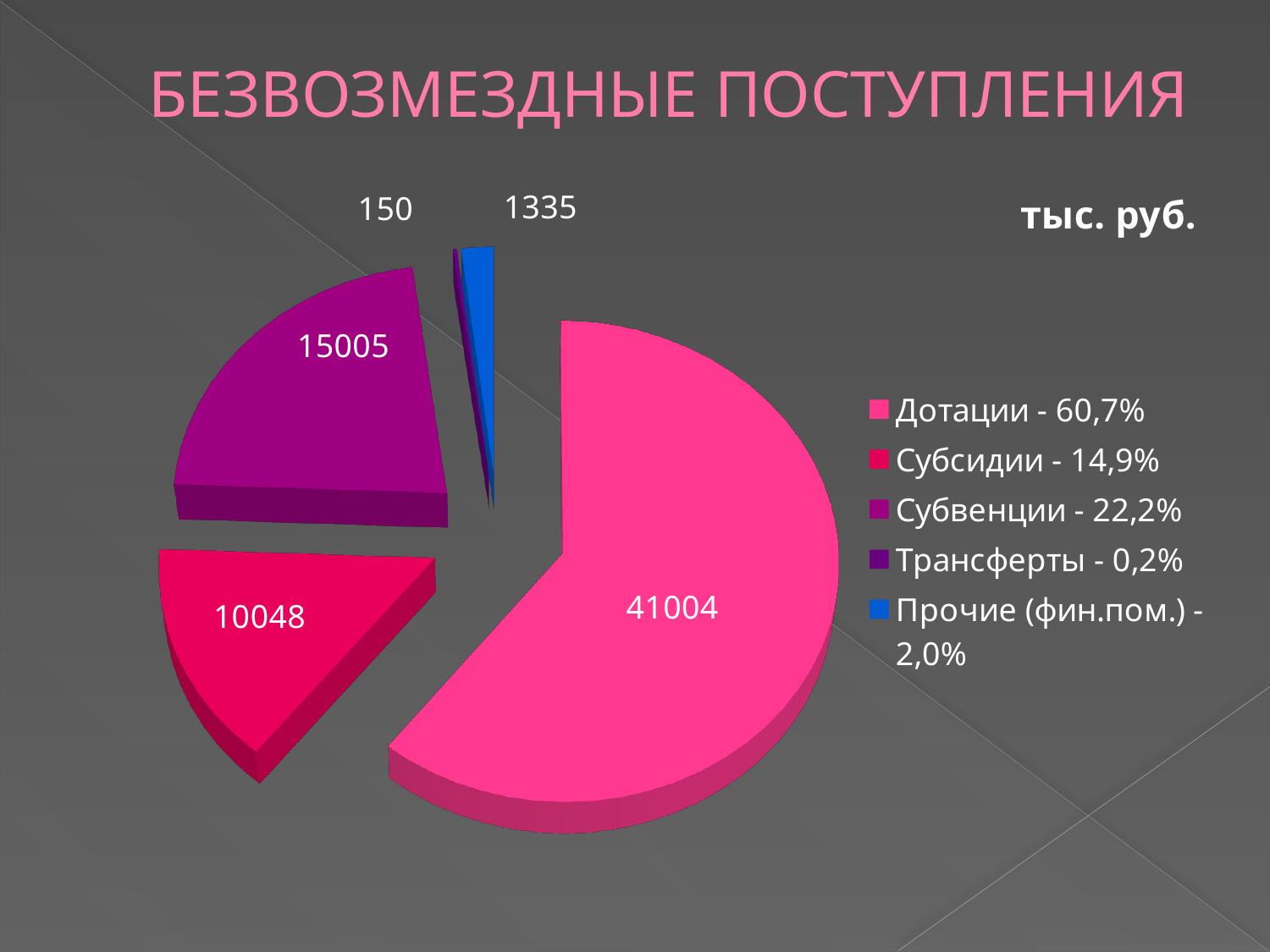
Which category has the smallest slice? Трансферты What kind of chart is shown on the slide? pie chart What is the value for Субвенции? 15005 Which is larger, the value for Субсидии or the value for Субвенции? Субвенции What is the value for Прочие (фин.пом.)? 1335 What is the value for Субсидии? 10048 What is the value for Дотации? 41004 What unit is indicated for the values on the chart? тыс. руб. What is the difference between the values for Субвенции and Субсидии? 4957 Which category has the largest slice? Дотации How many slices does the pie chart have? 5 What share of the pie does Субвенции represent according to the legend? 22,2%